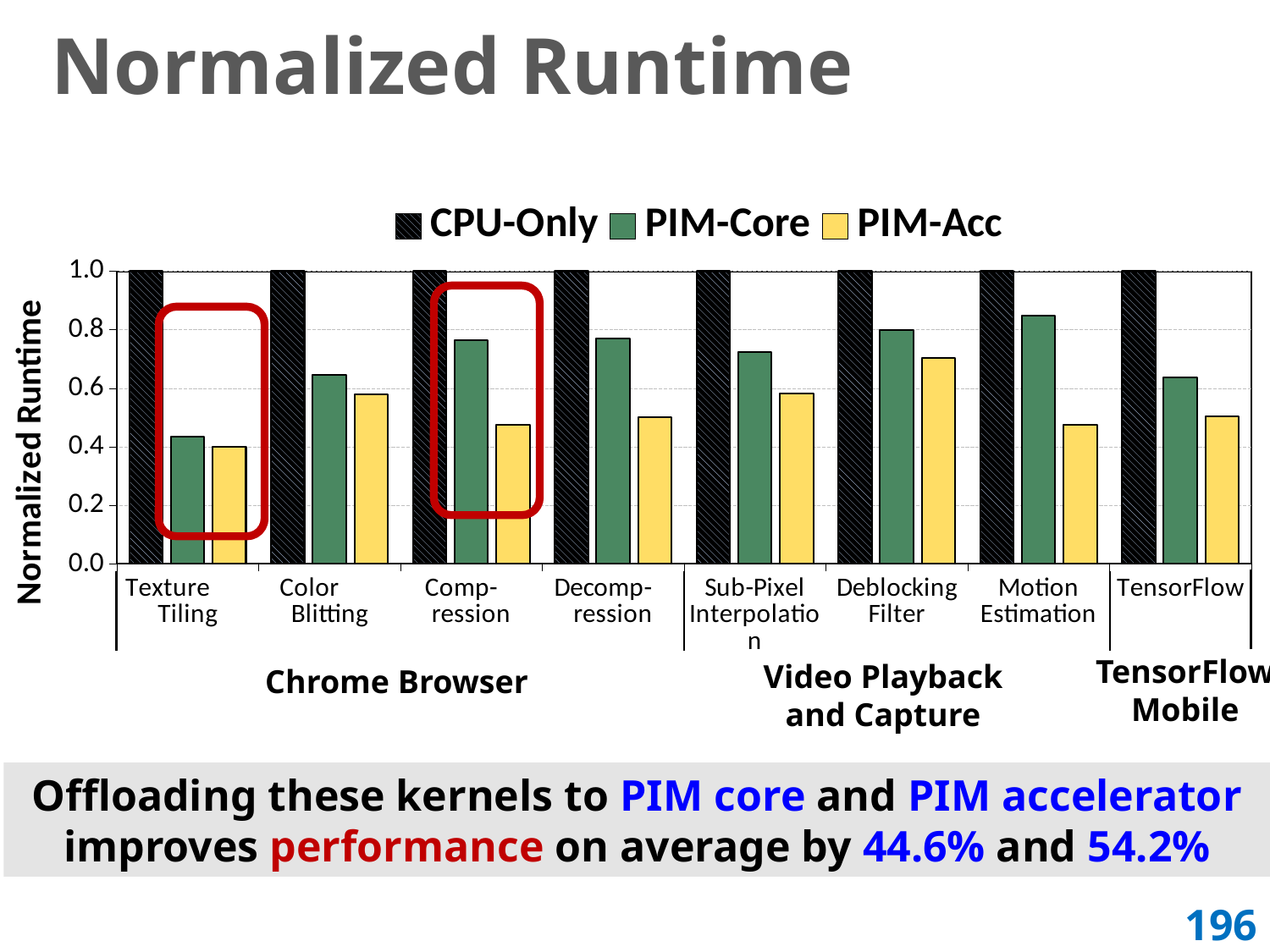
Is the PIM-Core value for Texture Tiling greater or less than 0.6? less Which kernel has the lowest PIM-Acc normalized runtime? Texture Tiling What kind of chart is shown on the slide? bar chart For Compression, which is larger: the PIM-Core value or the PIM-Acc value? PIM-Core Which kernel has the highest PIM-Core normalized runtime? Motion Estimation Which two kernels are highlighted with red boxes on the chart? Texture Tiling and Compression How many kernel categories are plotted along the x axis? 8 How many series does the legend list? 3 Is the PIM-Acc value for Deblocking Filter greater or less than 0.6? greater Which is larger: the PIM-Core value for Color Blitting or the PIM-Core value for Decompression? Decompression What is the CPU-Only normalized runtime for Texture Tiling? 1.0 Is the PIM-Core value for Motion Estimation greater or less than 0.8? greater